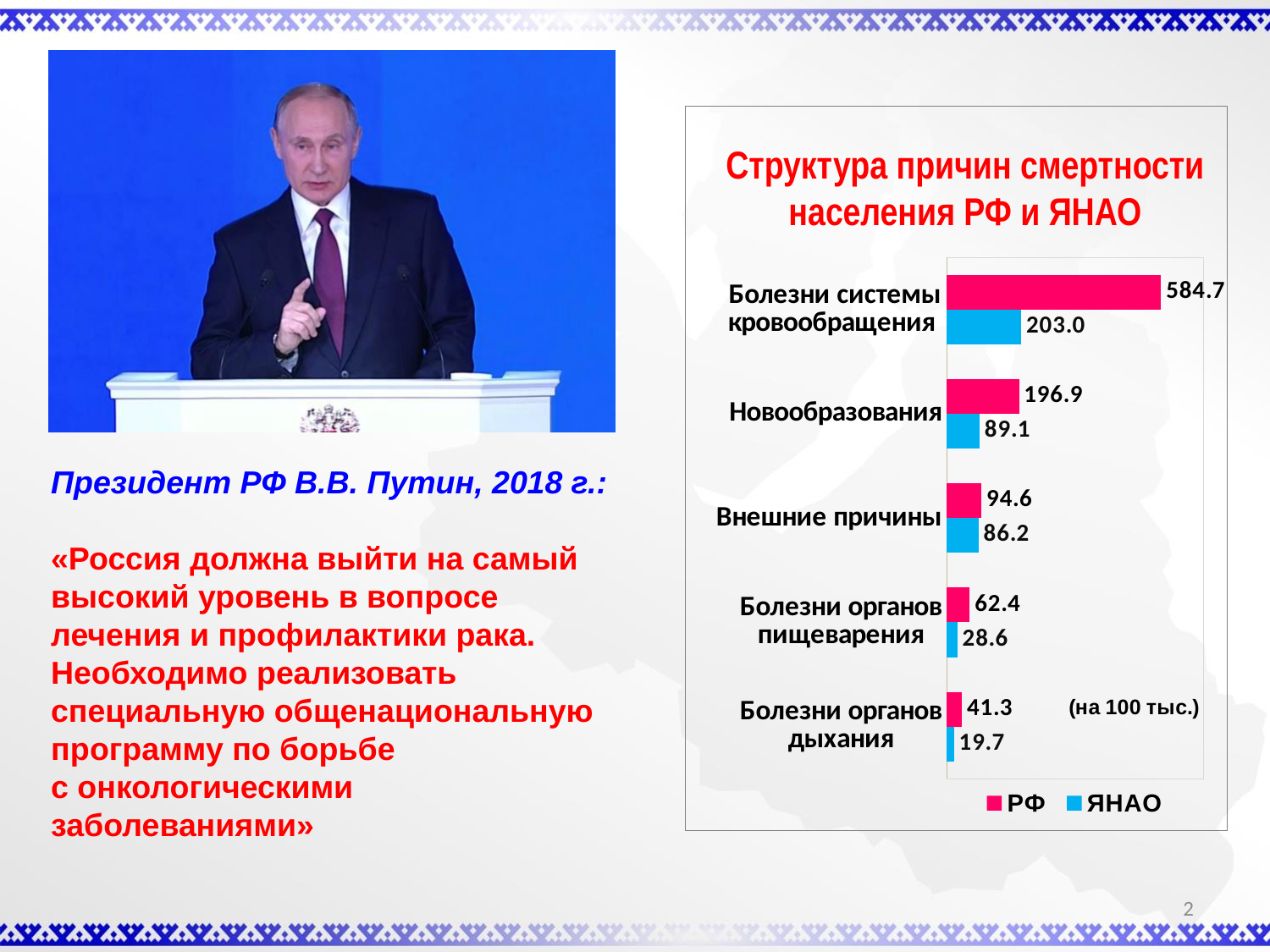
What is the value for ЯНАО for Новообразования? 89.1 What is the difference between the РФ and ЯНАО values for Внешние причины? 8.4 How many series does the legend list? 2 What is the difference between the РФ and ЯНАО values for Болезни системы кровообращения? 381.7 What kind of chart is shown on the slide? Bar chart What is the title of the chart? Структура причин смертности населения РФ и ЯНАО Which category has the lowest value for ЯНАО? Болезни органов дыхания Which is larger: the РФ value for Новообразования or the ЯНАО value for Болезни системы кровообращения? ЯНАО value for Болезни системы кровообращения What is the value for ЯНАО for Болезни органов дыхания? 19.7 Which category has the highest value for РФ? Болезни системы кровообращения What is the value for РФ for Болезни системы кровообращения? 584.7 How many categories are shown in the chart? 5